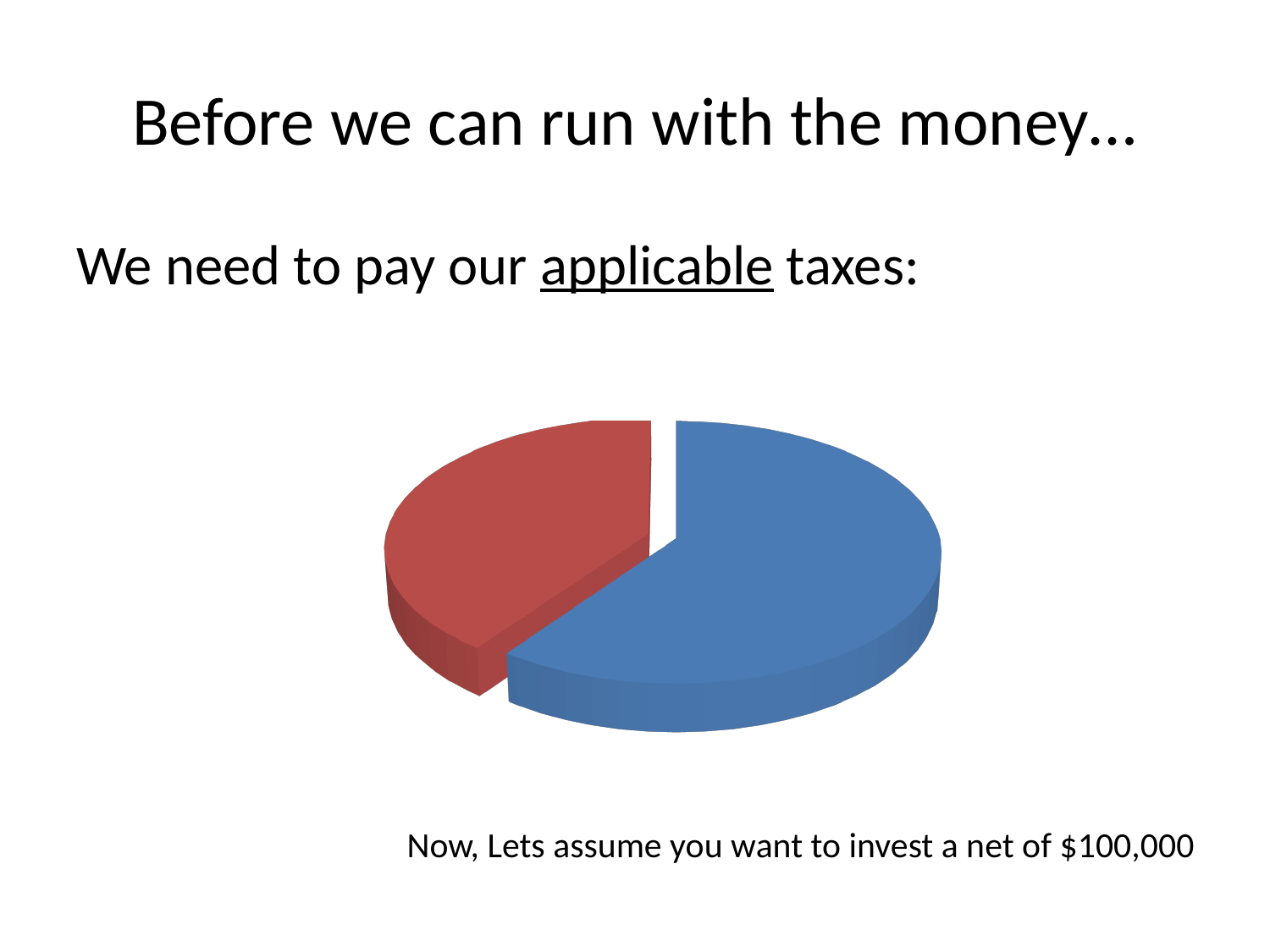
Which slice of the pie chart is the largest? the blue slice What two colours are used for the slices of the pie chart? blue and red Does the pie chart display a legend? No Which slice of the pie chart is the smallest? the red slice How many slices does the pie chart have? 2 Which slice of the pie chart is larger, the blue one or the red one? the blue one What kind of chart is shown on the slide? pie chart